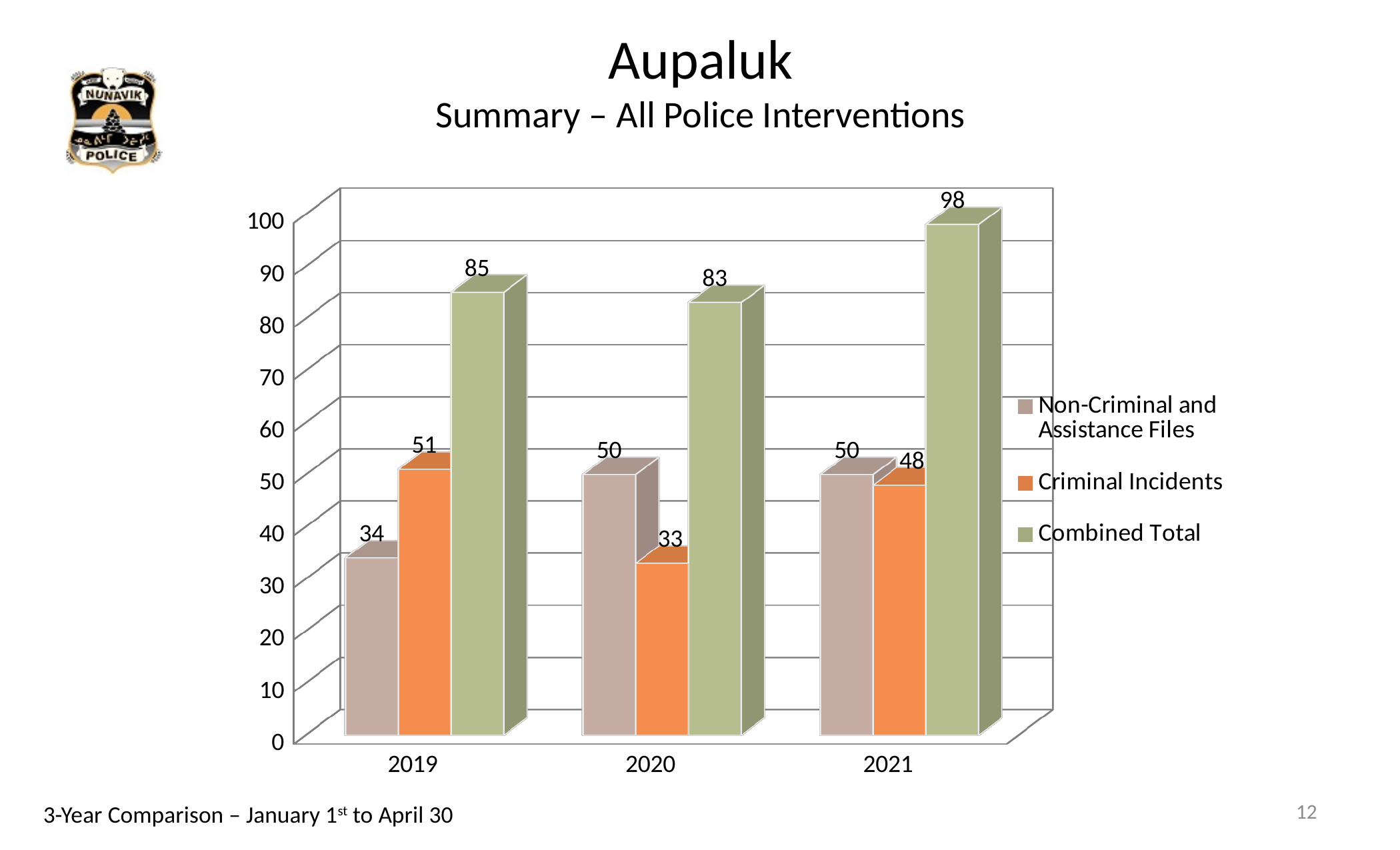
In which year is the Criminal Incidents value lowest? 2020 Which is larger in 2019: Non-Criminal and Assistance Files or Criminal Incidents? Criminal Incidents What is the difference between the Combined Total in 2021 and in 2020? 15 How many years are shown on the x axis? 3 How many series does the legend list? 3 What is the Combined Total for 2021? 98 What kind of chart is shown on the slide? Bar chart What is the value of Non-Criminal and Assistance Files in 2020? 50 Does the Non-Criminal and Assistance Files value rise or fall from 2019 to 2020? Rise What is the value of Criminal Incidents in 2019? 51 In which year is the Combined Total highest? 2021 Which series is shown in orange in the legend? Criminal Incidents